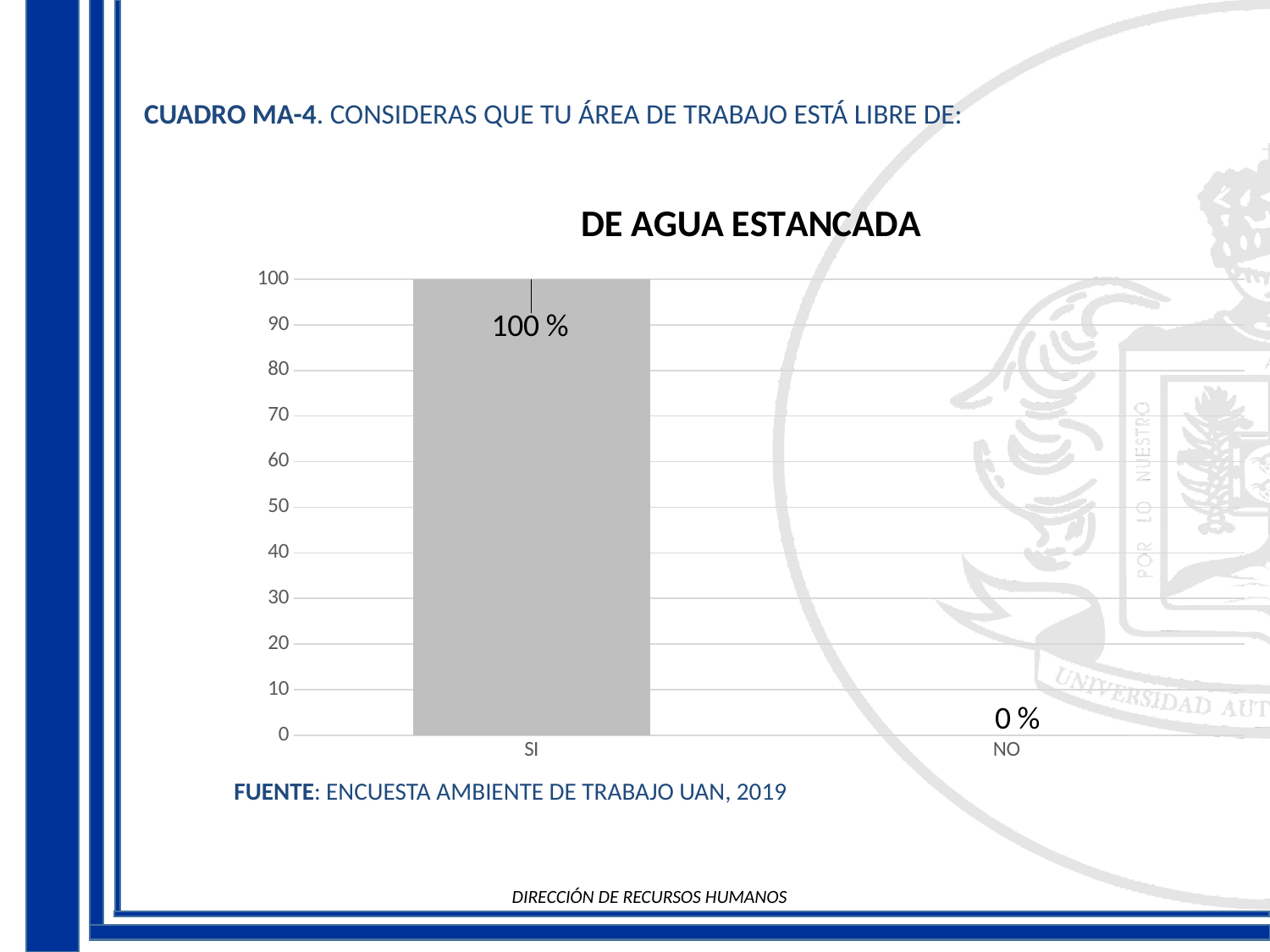
What is the value for SI? 100 % What is the title of the chart? DE AGUA ESTANCADA Do the values rise or fall from SI to NO along the x axis? fall What is the difference between the values for SI and NO? 100 % Is the value for SI greater or less than 50? greater Which category has the highest value? SI What is the value for NO? 0 % Which is larger, the value for SI or the value for NO? SI Which category has the lowest value? NO What is the highest value shown on the vertical axis? 100 What kind of chart is shown on the slide? bar chart How many categories are shown on the x axis? 2